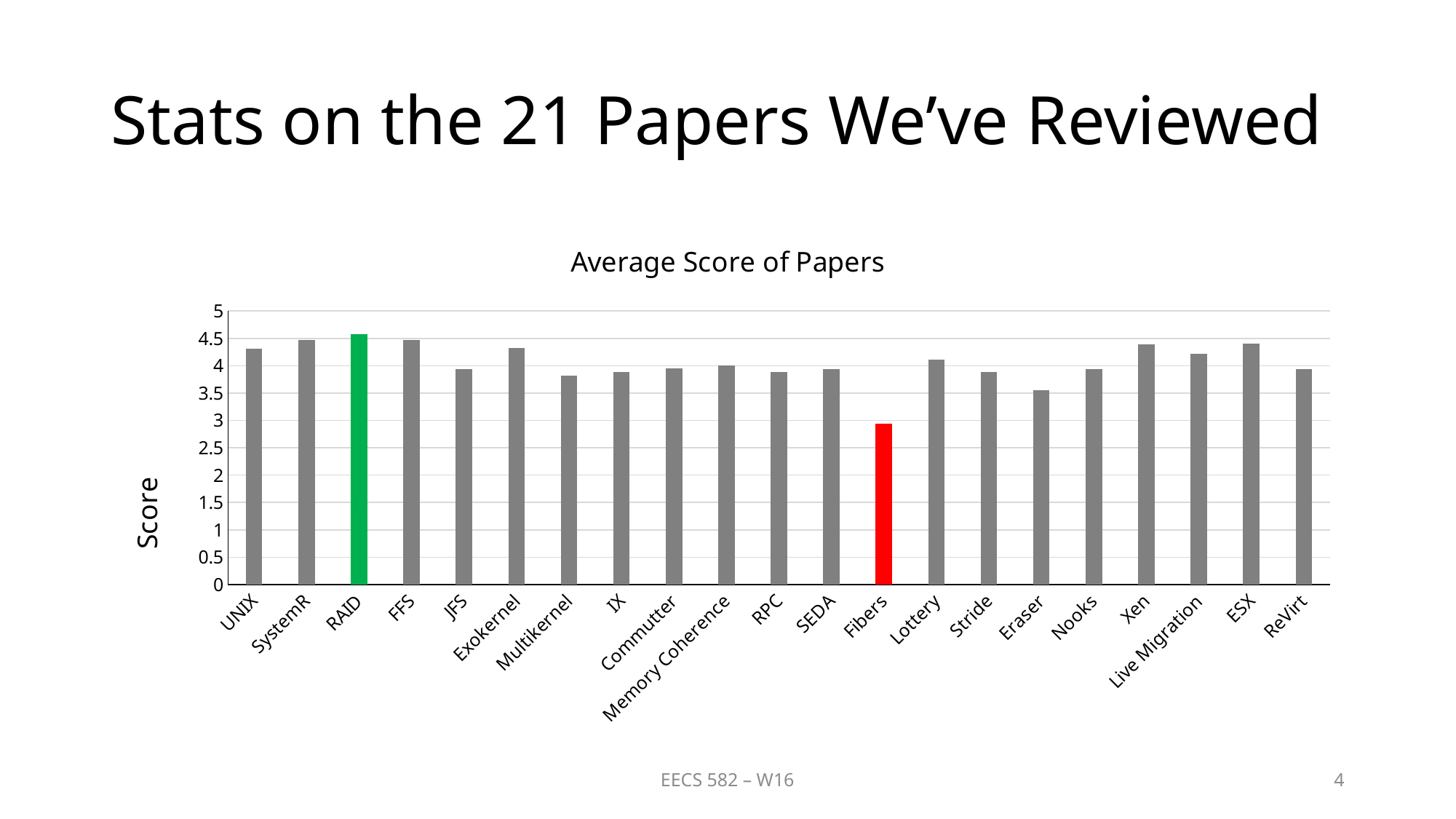
Is the average score for UNIX greater or less than 4? greater What kind of chart is shown on the slide? bar chart Which paper has the lowest average score? Fibers What is the title of the chart? Average Score of Papers Which paper has the highest average score? RAID Which has a higher average score, Eraser or Fibers? Eraser Which has a higher average score, UNIX or JFS? UNIX Is the average score for Eraser greater or less than 4? less How many papers (categories) are plotted on the x axis of the chart? 21 Is the average score for Multikernel greater or less than 4? less